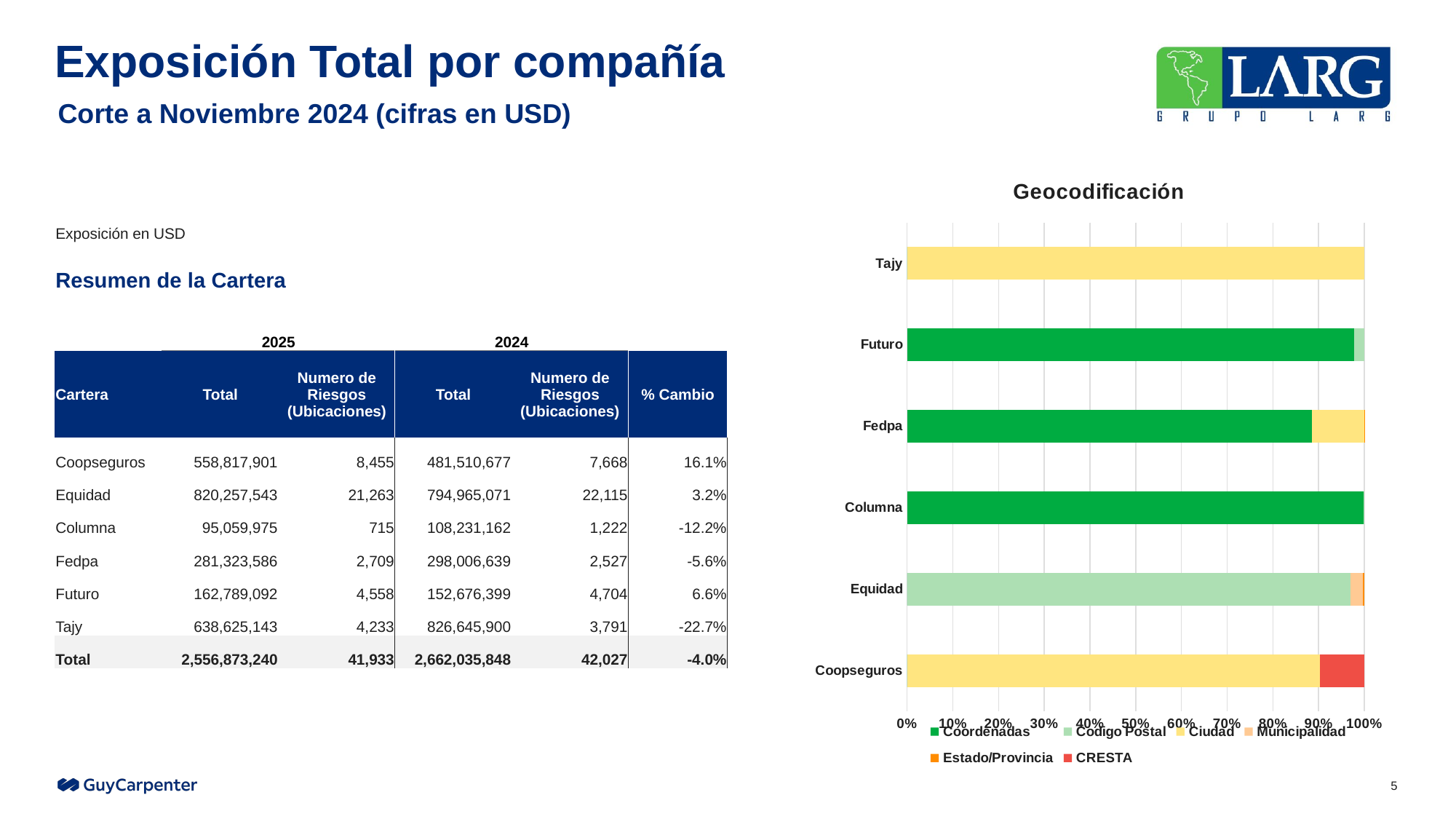
On the Geocodificación chart, which colour represents the CRESTA series? red What is the title of the chart on the slide? Geocodificación On the Geocodificación chart, is the Ciudad value for Fedpa greater or less than 20%? less How many categories (companies) are shown on the Geocodificación chart? 6 On the Geocodificación chart, is the Coordenadas value for Futuro greater or less than 90%? greater On the Geocodificación chart, is the CRESTA value for Coopseguros greater or less than 20%? less On the Geocodificación chart, which has the larger Coordenadas share, Columna or Fedpa? Columna How many series does the legend of the Geocodificación chart list? 6 What kind of chart is the Geocodificación chart? stacked bar chart